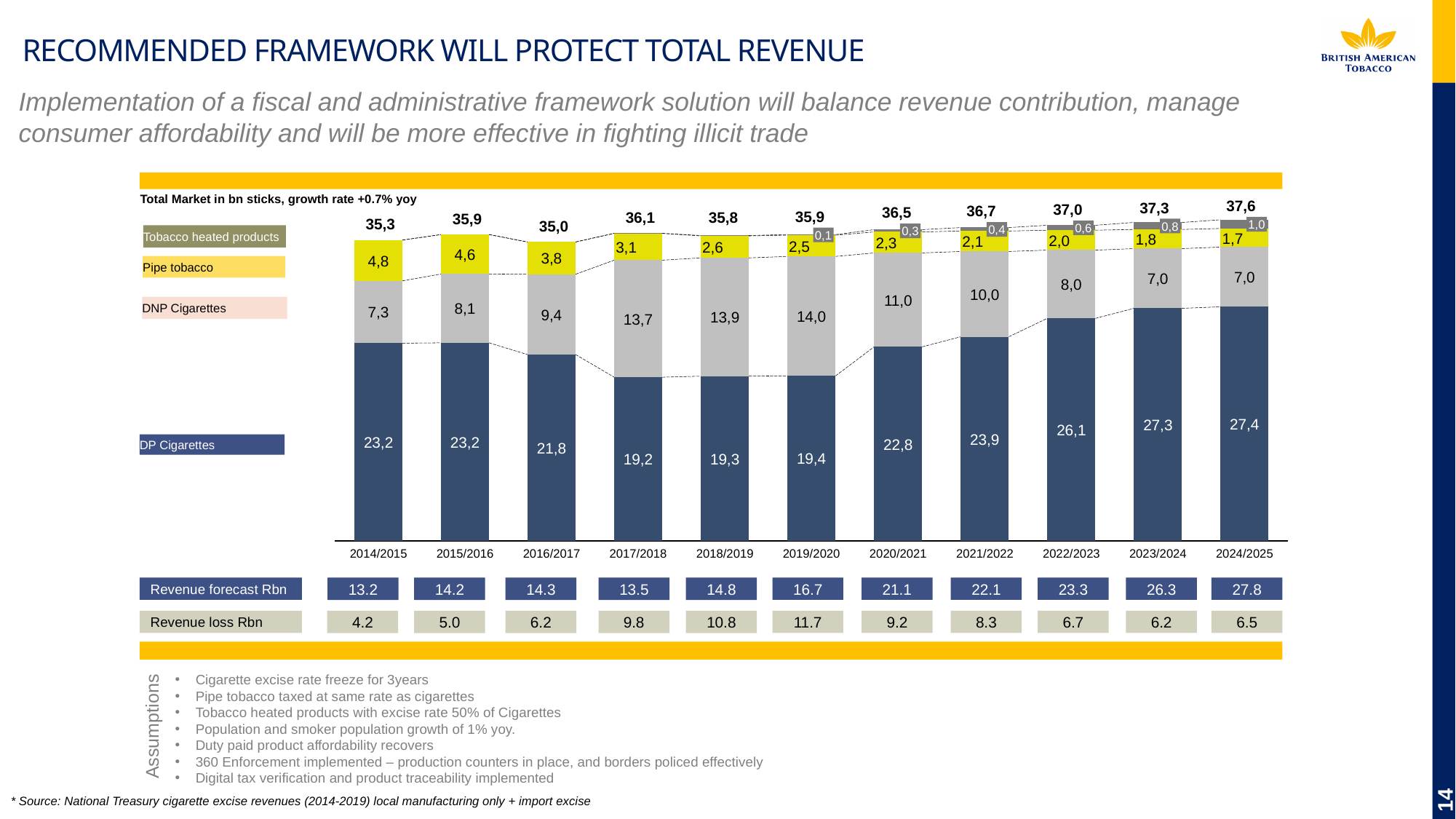
What is the difference between the DP Cigarettes value in 2024/2025 and in 2014/2015? 4,2 What is the value for DNP Cigarettes in 2017/2018? 13,7 How many series does the chart legend list? 4 Does the Pipe tobacco value rise or fall from 2014/2015 to 2024/2025? Fall How many years are shown on the x axis of the chart? 11 What kind of chart is shown on the slide? Stacked bar chart In which year is the DNP Cigarettes value highest? 2019/2020 What is the value for Tobacco heated products in 2020/2021? 0,3 What is the total market value shown above the 2024/2025 bar? 37,6 Which is larger, the Pipe tobacco value in 2014/2015 or in 2024/2025? 2014/2015 In which year is the DP Cigarettes value lowest? 2017/2018 What is the value for DP Cigarettes in 2024/2025? 27,4